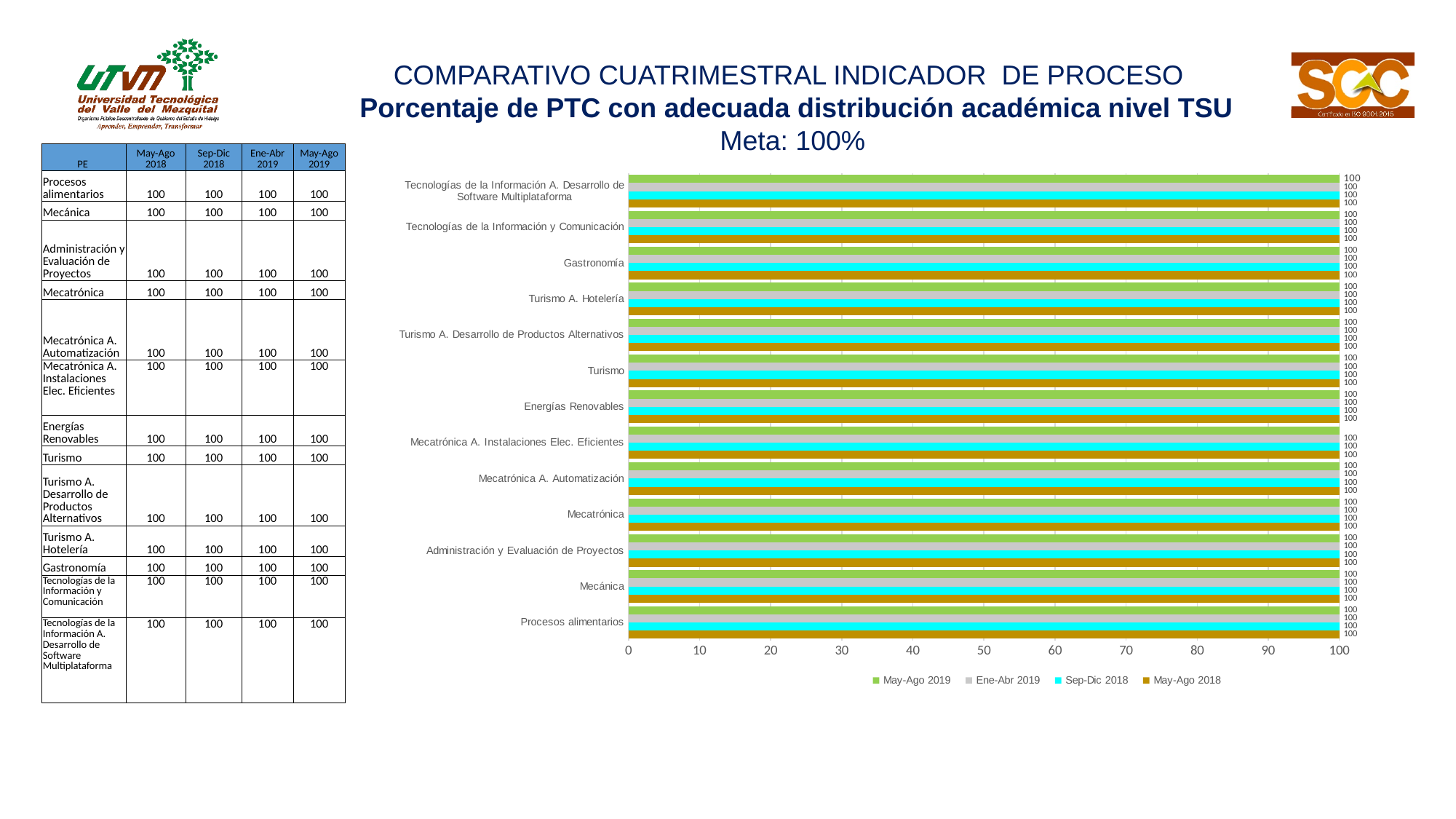
What is the difference between the May-Ago 2019 value for Mecatrónica and the May-Ago 2018 value for Mecatrónica? 0 What is the May-Ago 2018 value for Energías Renovables? 100 How many categories (programs) are plotted on the chart? 13 What is the Sep-Dic 2018 value for Tecnologías de la Información y Comunicación? 100 What is the May-Ago 2019 value for Gastronomía? 100 What is the Ene-Abr 2019 value for Mecánica? 100 What is the Sep-Dic 2018 value for Turismo? 100 How many series does the chart legend list? 4 Which series is listed first in the chart legend? May-Ago 2019 What kind of chart is shown on the slide? bar chart What is the maximum value shown on the chart's horizontal axis? 100 Is the Ene-Abr 2019 value for Procesos alimentarios greater or less than 90? greater